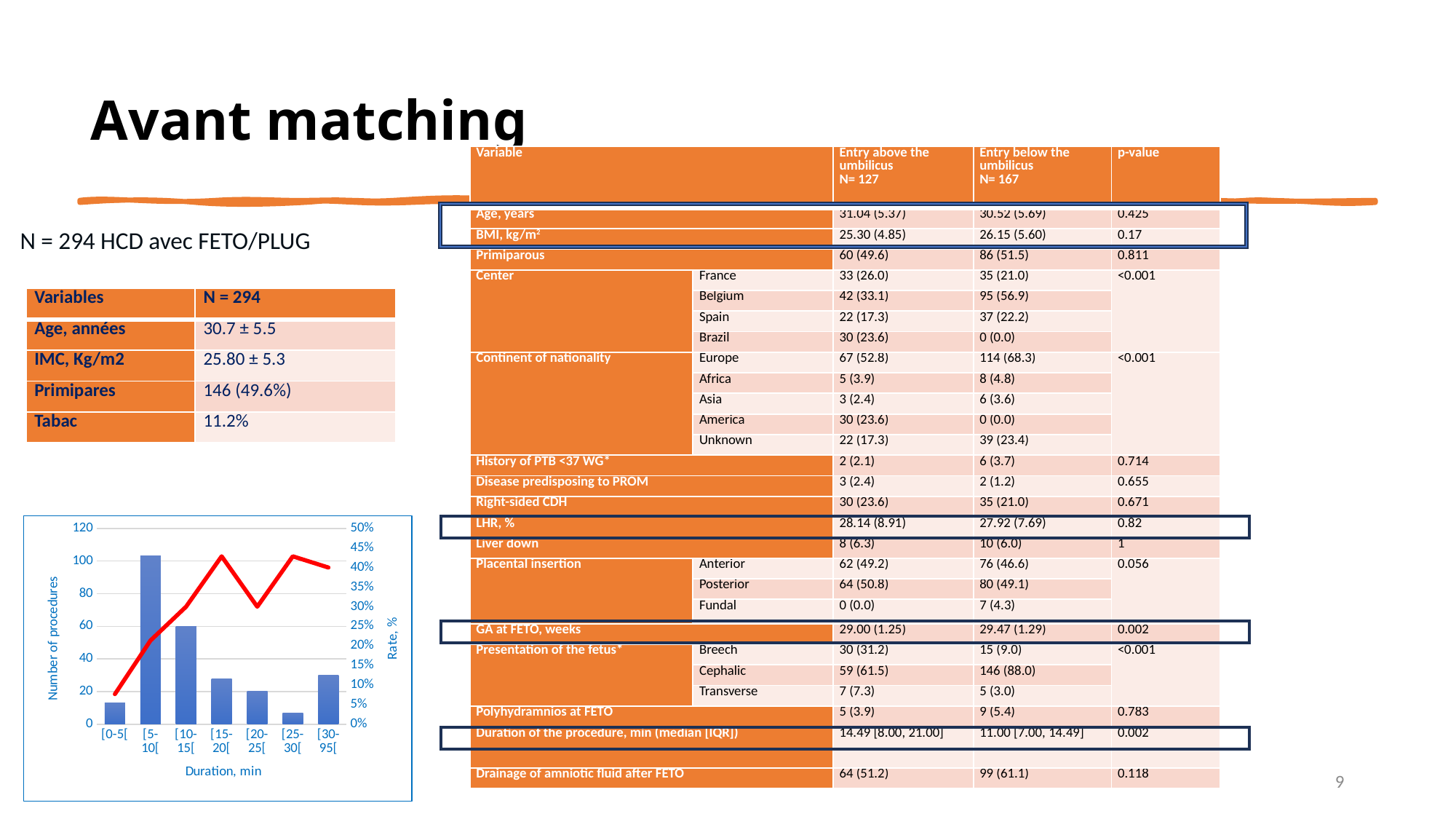
What kind of chart is shown on the slide? Bar chart with a line overlay Which duration category has the highest number of procedures in the chart? [5-10[ Do the bars rise or fall from [5-10[ to [25-30[ in the chart? fall Which duration category has the lowest number of procedures in the chart? [25-30[ Is the number of procedures for [30-95[ greater or less than 20? greater Is the number of procedures for [15-20[ greater or less than 40? less Is the number of procedures for [10-15[ greater or less than 80? less Which has more procedures in the chart, [10-15[ or [15-20[? [10-15[ What is the title of the right-hand y axis of the chart? Rate, % How many duration categories are shown on the x axis of the chart? 7 What is the title of the x axis of the chart? Duration, min